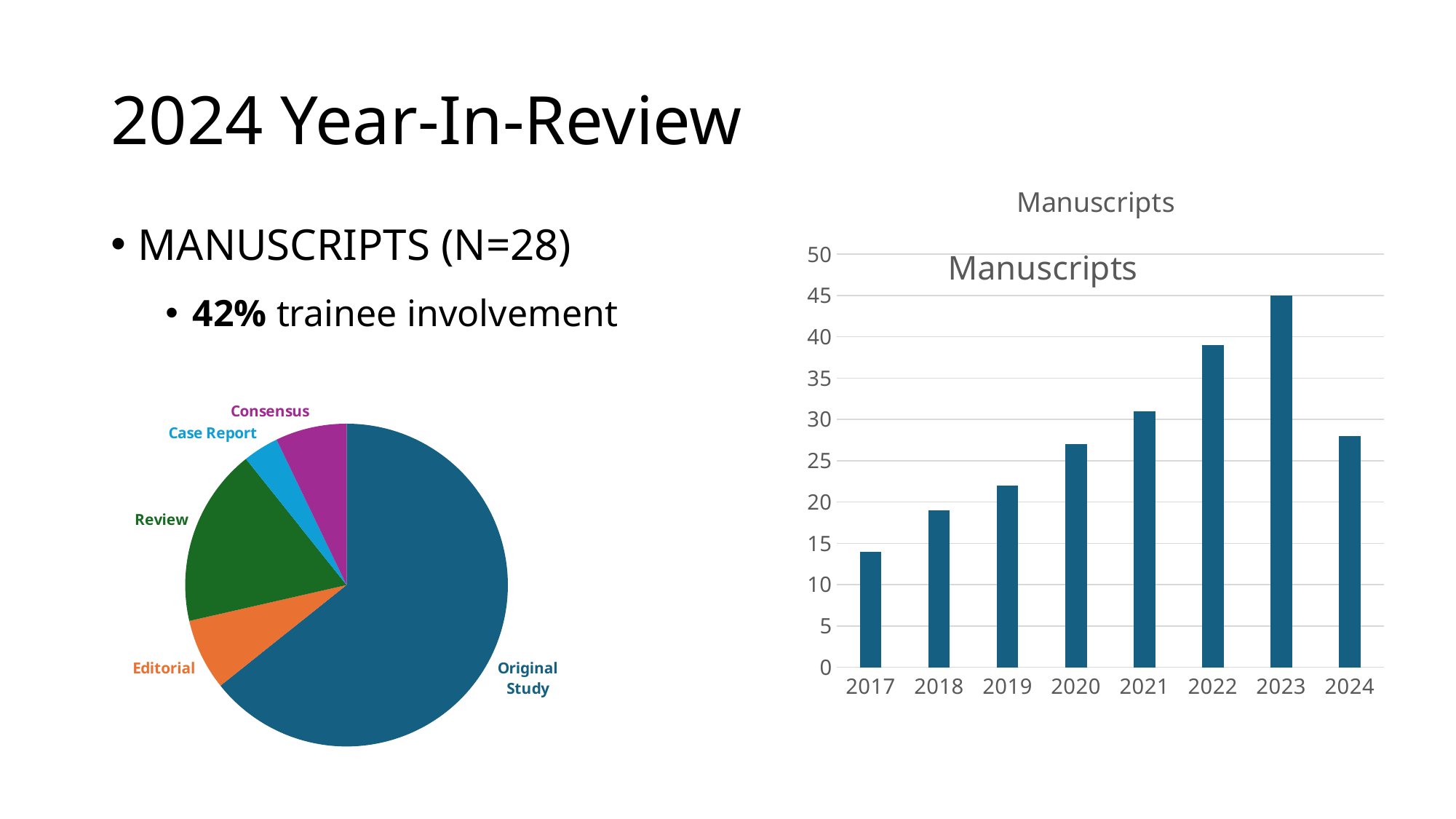
In the Manuscripts bar chart, is the value for 2020 greater or less than 25? greater What kind of chart is the chart on the right of the slide? bar chart In the Manuscripts bar chart, do the values rise or fall from 2017 to 2023? rise In the Manuscripts bar chart, which year has the lowest value? 2017 In the Manuscripts bar chart, is the value for 2018 greater or less than 20? less In the Manuscripts bar chart, is the value for 2017 greater or less than 15? less What kind of chart is the chart on the left of the slide? pie chart In the pie chart on the left, which category has the largest slice? Original Study In the pie chart on the left, how many categories are shown? 5 In the Manuscripts bar chart, which is larger, the value for 2022 or the value for 2024? 2022 In the Manuscripts bar chart, which year has the highest value? 2023 In the Manuscripts bar chart, how many years are shown on the x axis? 8